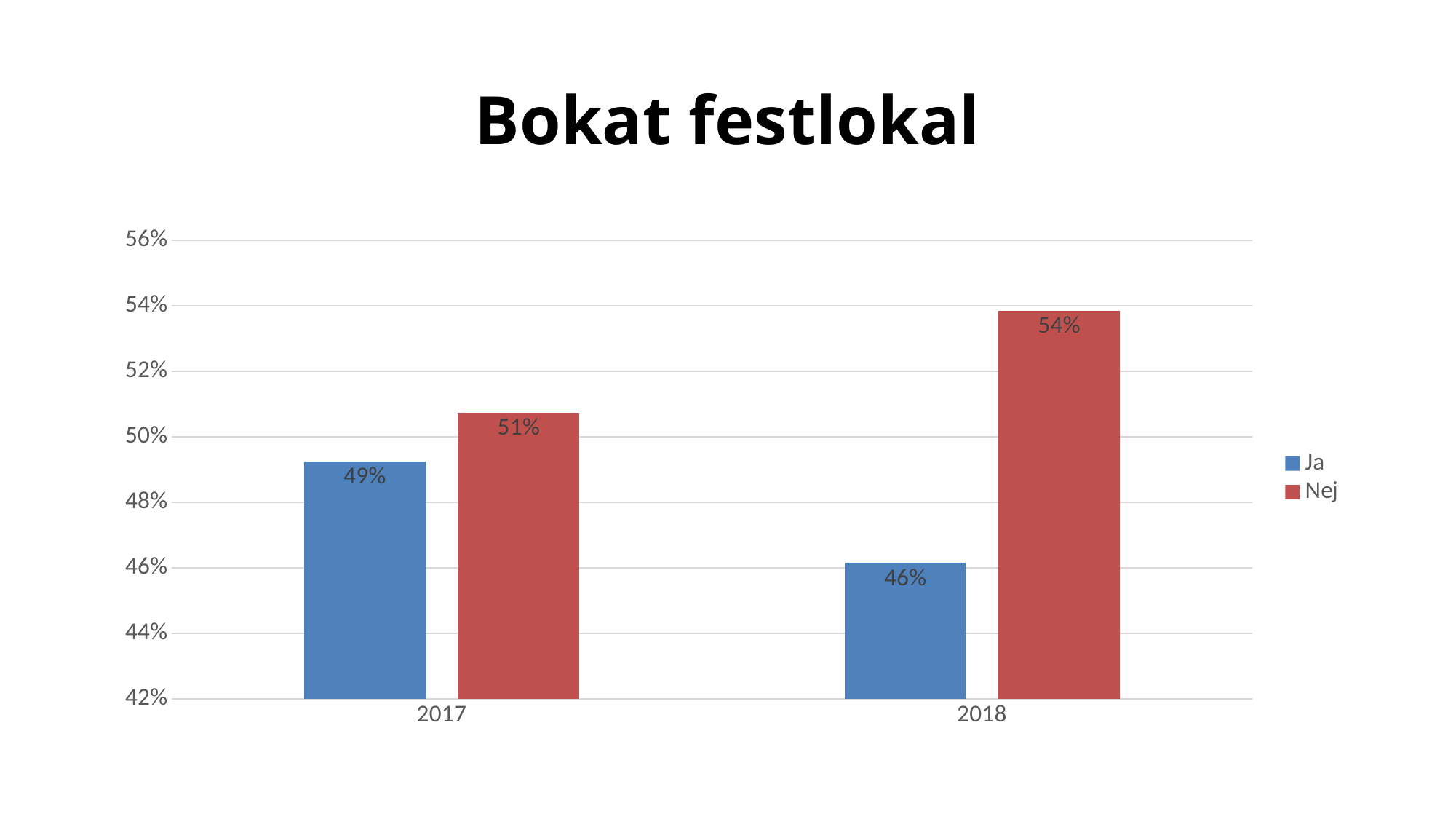
What is the value for Nej in 2017? 51% What is the value for Ja in 2017? 49% Which is larger in 2017, Ja or Nej? Nej How many series does the legend list? 2 Is the value for Ja in 2018 greater or less than 48%? less What is the title of the chart? Bokat festlokal Which bar has the lowest value on the chart? Ja in 2018 What is the difference between the Nej and Ja values in 2018? 8% Which bar has the highest value on the chart? Nej in 2018 What is the value for Ja in 2018? 46% What kind of chart is shown on the slide? Bar chart What is the value for Nej in 2018? 54%